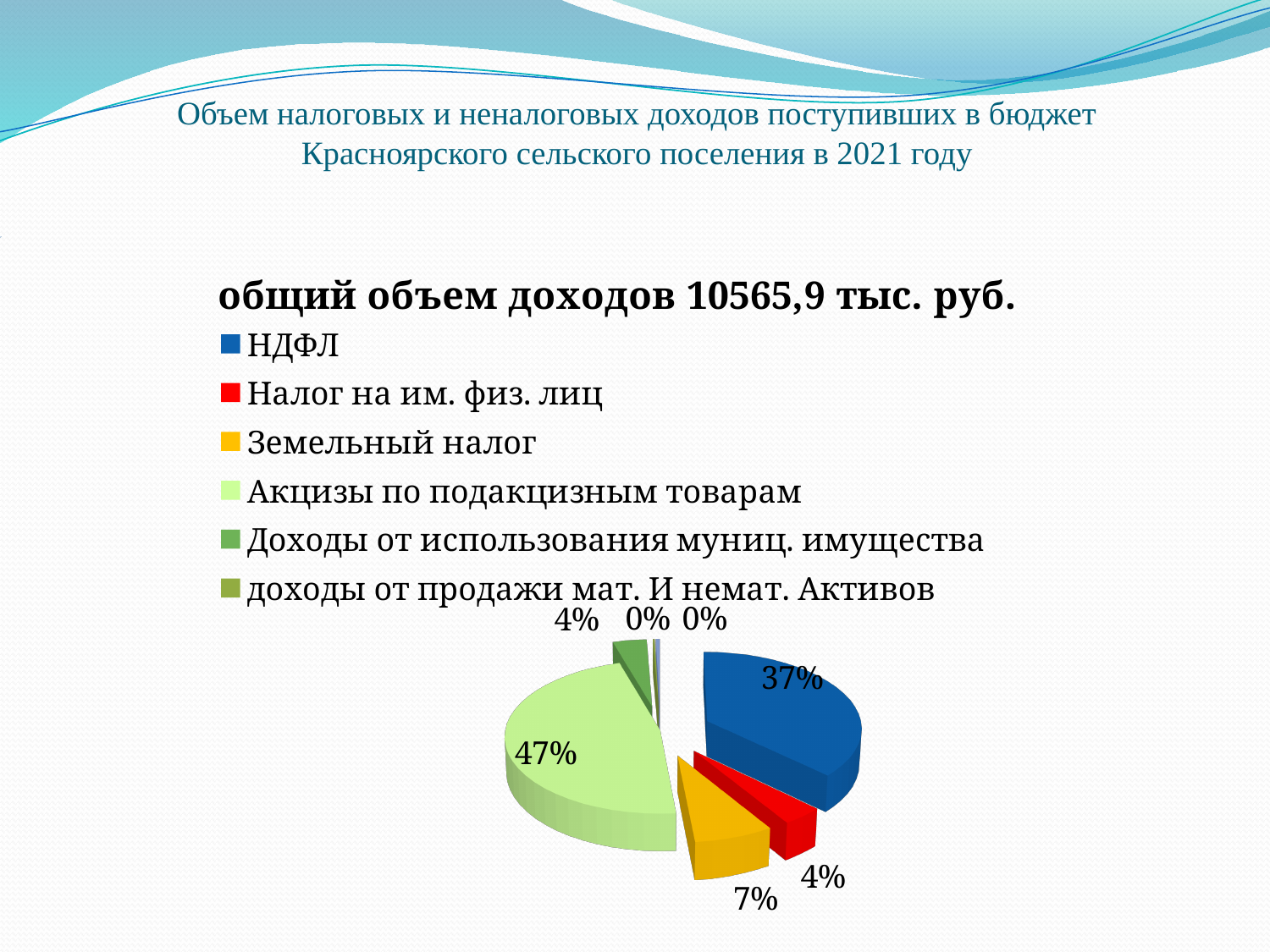
What kind of chart is shown on the slide? pie chart What share of the pie does Акцизы по подакцизным товарам account for? 47% What share of the pie does НДФЛ account for? 37% What share of the pie does Доходы от использования муниц. имущества account for? 4% Which is larger, the slice for НДФЛ or the slice for Акцизы по подакцизным товарам? Акцизы по подакцизным товарам By how many percentage points does the share of Акцизы по подакцизным товарам exceed the share of НДФЛ? 10 percentage points What share of the pie does Земельный налог account for? 7% Which category has the largest slice of the pie? Акцизы по подакцизным товарам By how many percentage points does the share of Земельный налог exceed the share of Налог на им. физ. лиц? 3 percentage points How many entries does the chart legend list? 6 What is the title of the chart? общий объем доходов 10565,9 тыс. руб. What share of the pie does Налог на им. физ. лиц account for? 4%